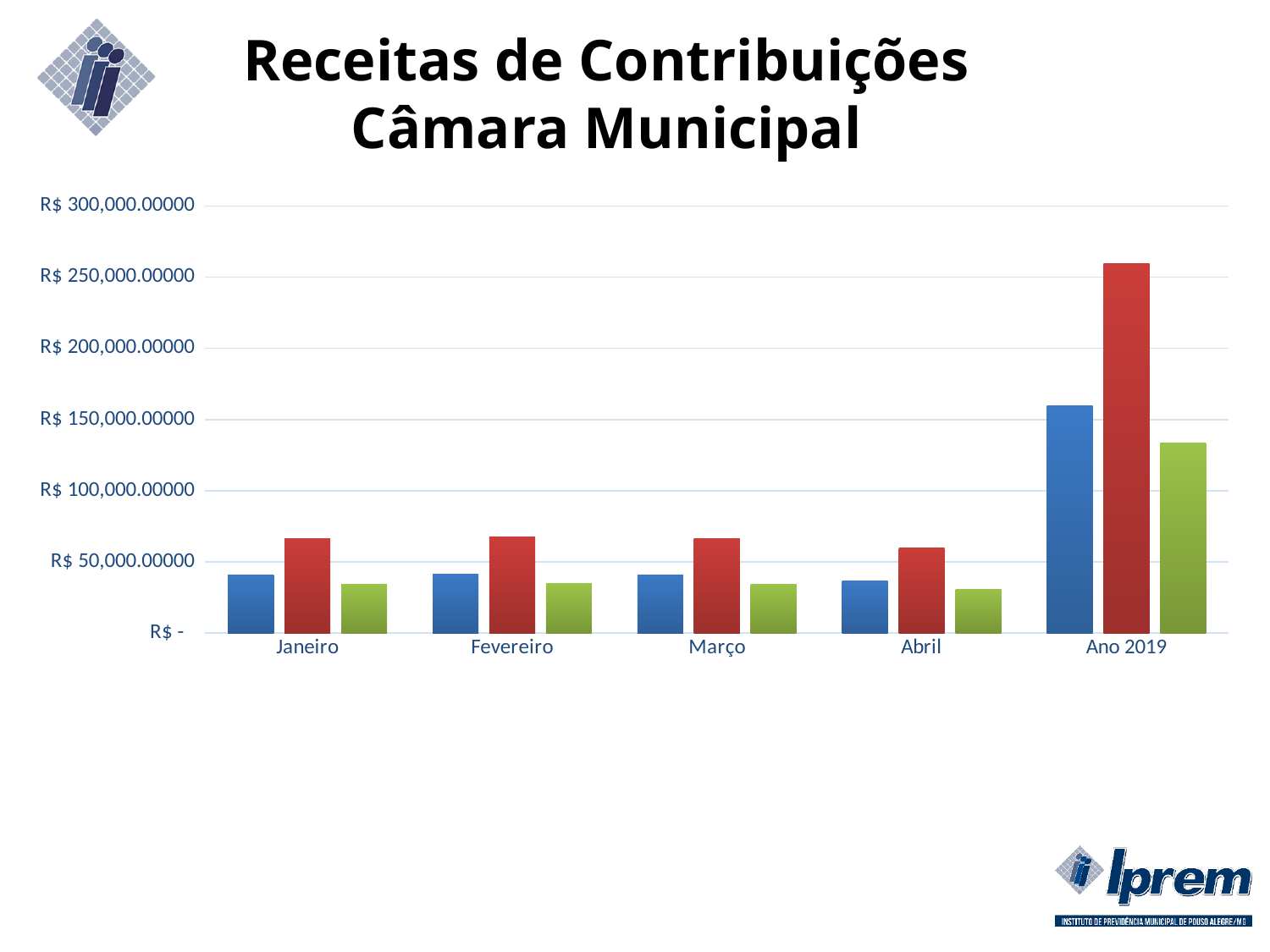
How many bars are plotted for each category on the chart? 3 In the Ano 2019 category, which coloured bar is the tallest? red What kind of chart is shown on the slide? bar chart Is the value of the green bar for Ano 2019 greater or less than R$ 150,000.00000? less How many categories are shown on the x axis of the chart? 5 Is the value of the red bar for Janeiro greater or less than R$ 50,000.00000? greater Which category has the tallest red bar? Ano 2019 Which is larger: the red bar for Fevereiro or the blue bar for Ano 2019? the blue bar for Ano 2019 Among the four months (Janeiro to Abril), which has the shortest green bar? Abril Is the value of the blue bar for Ano 2019 greater or less than R$ 150,000.00000? greater What is the title of the chart on the slide? Receitas de Contribuições Câmara Municipal